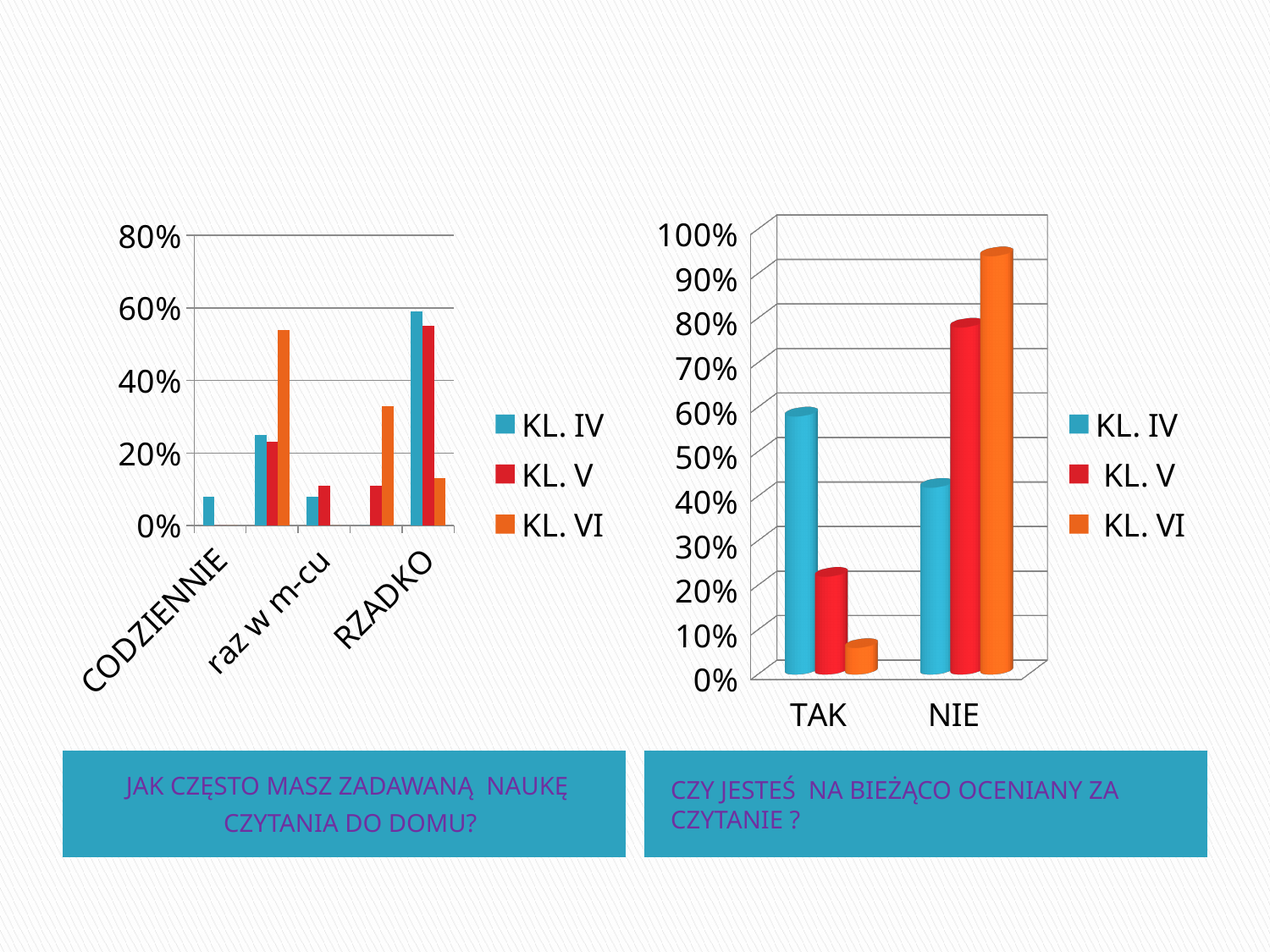
On the right chart, is the value for KL. IV in the TAK category greater or less than 50%? greater On the right chart, which series has the highest value in the NIE category? KL. VI What kind of chart is the right chart (CZY JESTEŚ NA BIEŻĄCO OCENIANY ZA CZYTANIE?)? bar chart On the right chart (CZY JESTEŚ NA BIEŻĄCO OCENIANY ZA CZYTANIE?), how many series does the legend list? 3 On the right chart, is the value for KL. VI in the TAK category greater or less than 10%? less On the right chart, in the TAK category, which is larger: KL. IV or KL. V? KL. IV On the left chart, is the value for KL. IV in the RZADKO category greater or less than 40%? greater On the right chart, which series has the lowest value in the TAK category? KL. VI On the right chart (CZY JESTEŚ NA BIEŻĄCO OCENIANY ZA CZYTANIE?), how many categories are shown on the x axis? 2 On the left chart (JAK CZĘSTO MASZ ZADAWANĄ NAUKĘ CZYTANIA DO DOMU?), how many series does the legend list? 3